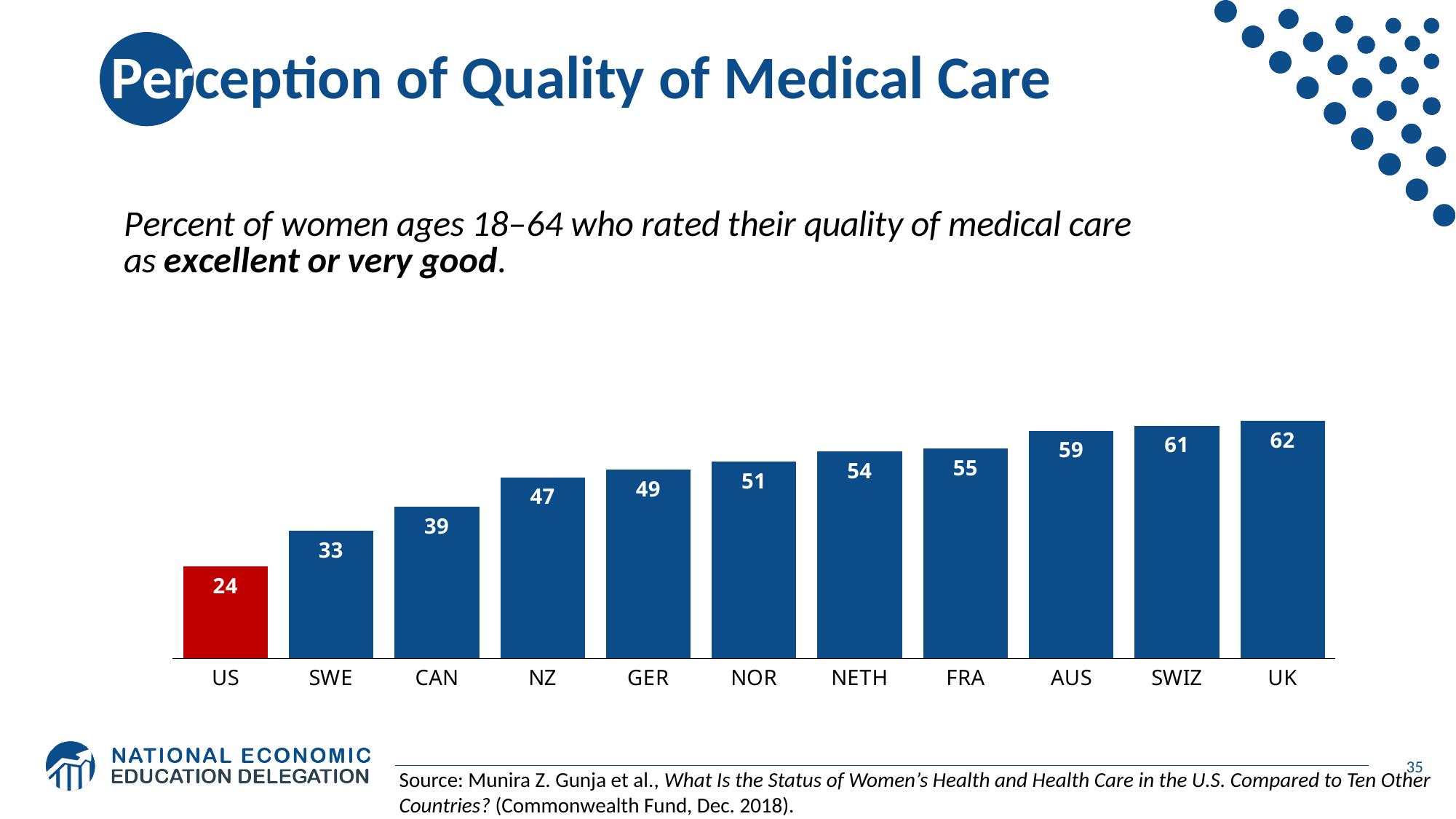
How many countries are shown in the chart? 11 What is the value for the US? 24 Which has a larger value, NOR or NZ? NOR What is the value for GER? 49 What is the value for AUS? 59 Do the values rise or fall from left to right across the countries? rise Which country has the highest value? UK What is the difference between the values for CAN and SWE? 6 What is the difference between the values for UK and US? 38 What kind of chart is shown on the slide? bar chart Which bar is coloured red instead of blue? US Which country has the lowest value? US